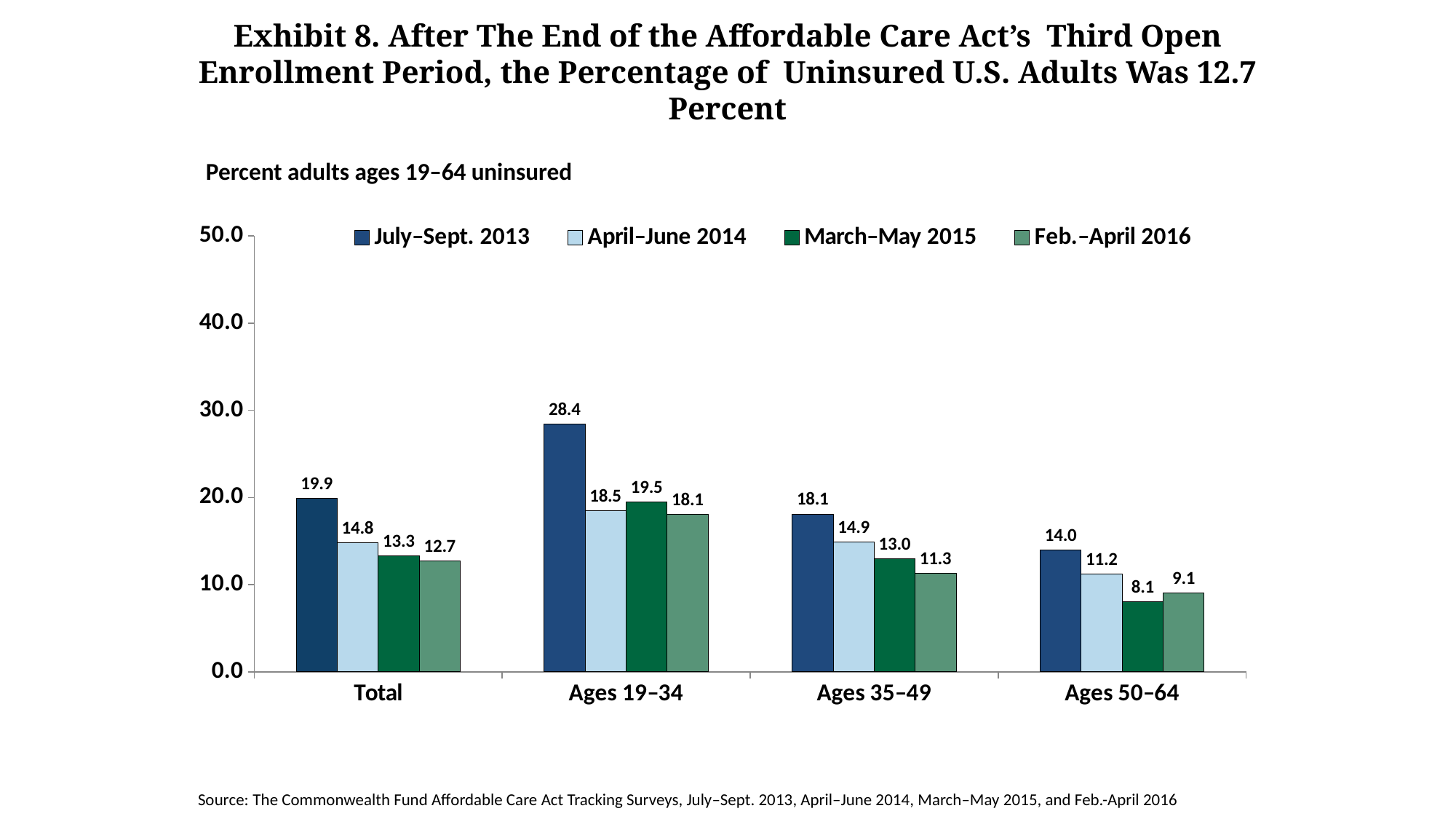
Which category has the lowest value in the Feb.–April 2016 series? Ages 50–64 How many series does the legend list? 4 Which age category has the highest value in the July–Sept. 2013 series? Ages 19–34 What kind of chart is shown on the slide? Bar chart How many categories are shown on the x axis? 4 What is the value for Ages 50–64 in the March–May 2015 series? 8.1 What is the difference between the July–Sept. 2013 and Feb.–April 2016 values for Total? 7.2 Which is larger for Ages 50–64: the March–May 2015 value or the Feb.–April 2016 value? Feb.–April 2016 Is the value for Ages 19–34 in the April–June 2014 series greater or less than 20.0? less What is the value for Total in the Feb.–April 2016 series? 12.7 Do the values for Ages 35–49 rise or fall from July–Sept. 2013 to Feb.–April 2016? Fall What is the value for Ages 19–34 in the July–Sept. 2013 series? 28.4